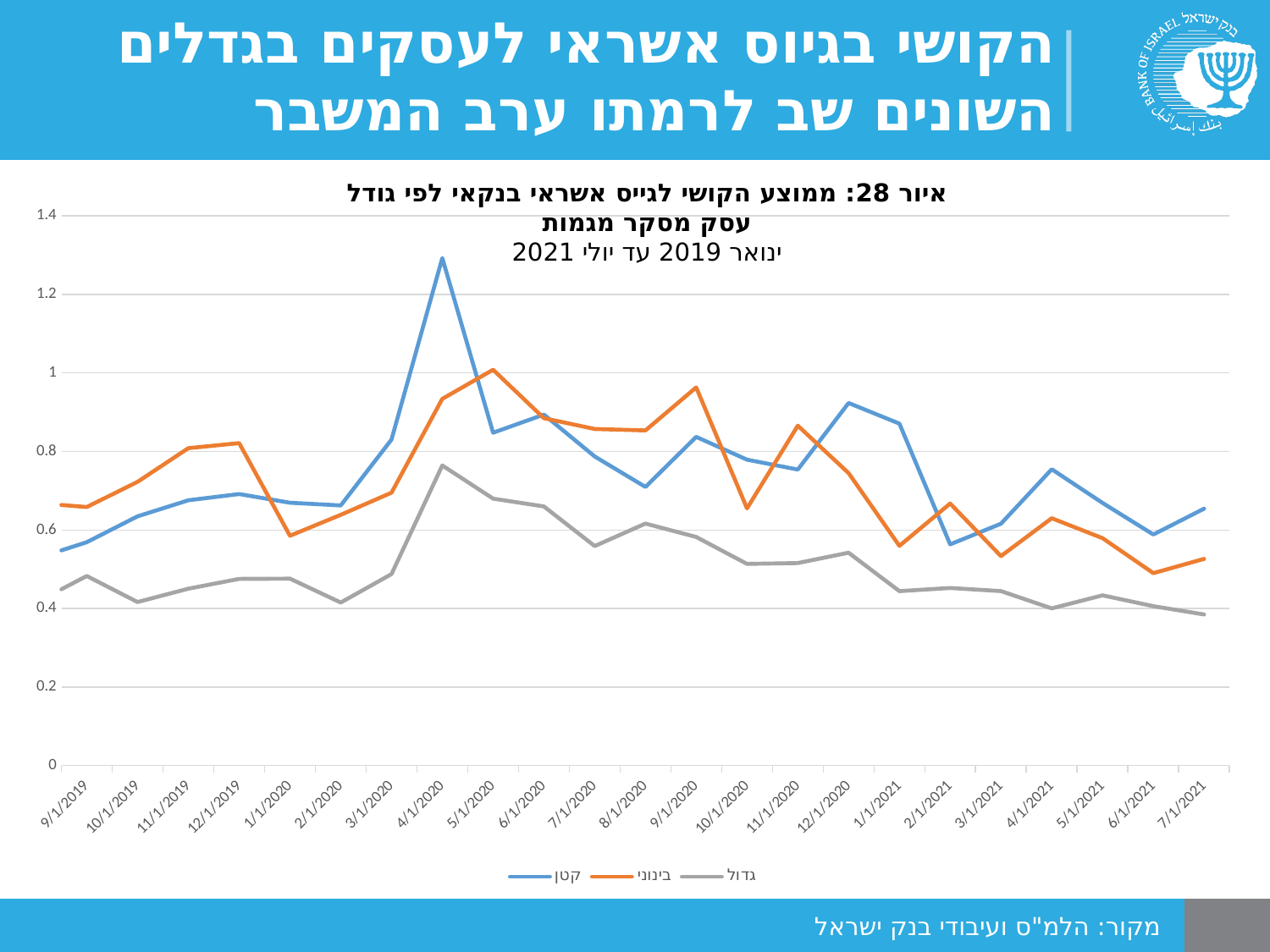
How many monthly data points are plotted along the x axis? 23 Which series reaches the highest value anywhere on the chart? קטן At which date does the קטן series reach its highest value? 4/1/2020 Which colour is used for the קטן series? blue At 11/1/2019, which series has the larger value, קטן or בינוני? בינוני How many series does the legend list? 3 Is the value for קטן at 4/1/2020 greater or less than 1.2? greater At 10/1/2020, which series has the larger value, קטן or בינוני? קטן Is the value for גדול at 4/1/2020 greater or less than 0.6? greater What kind of chart is shown on the slide? line chart Which series has the lowest values across the whole period? גדול Is the value for קטן at 9/1/2019 greater or less than 0.6? less